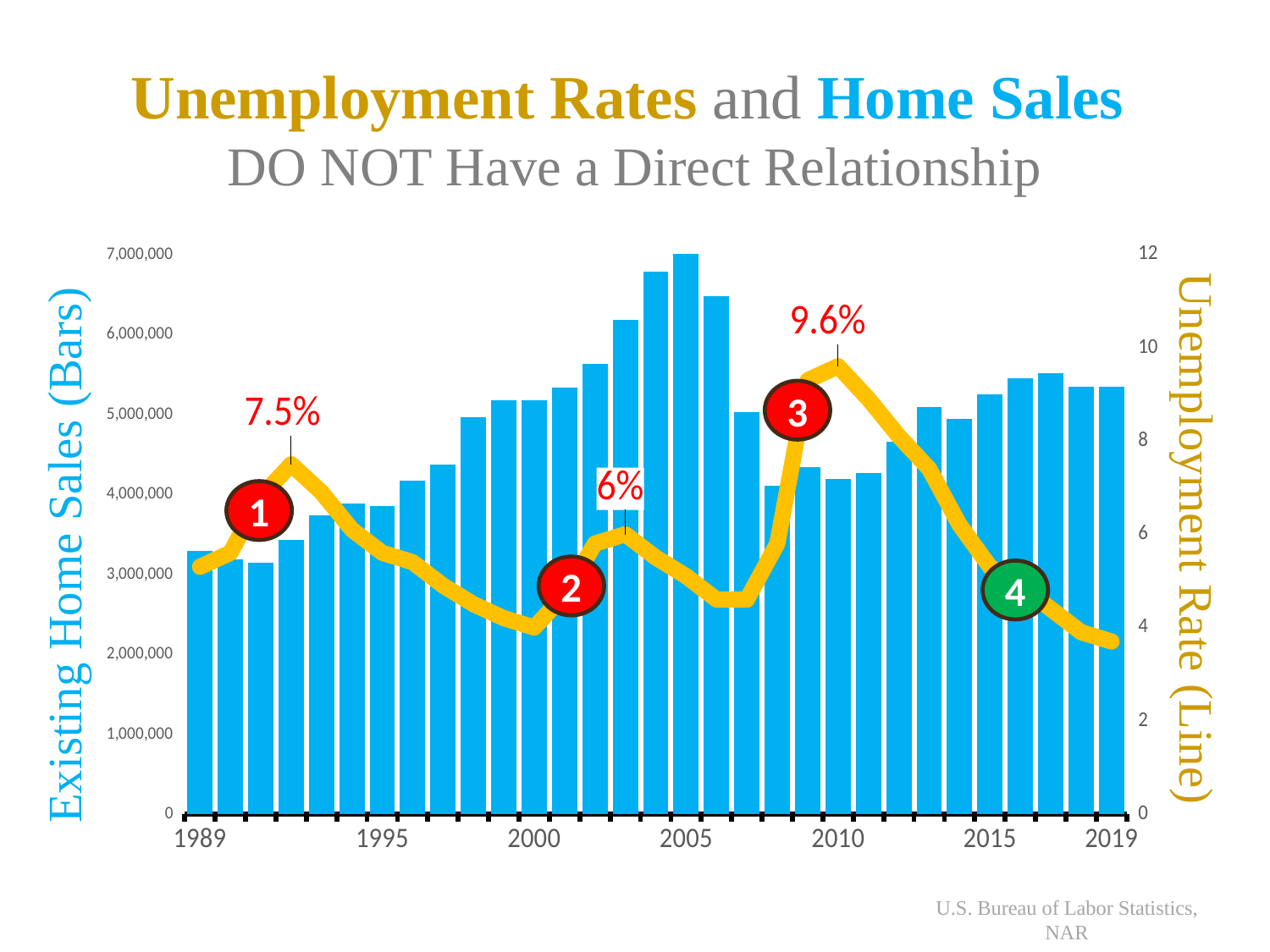
Is the existing home sales bar for 2010 greater or less than 5,000,000? less What is the title of the slide? Unemployment Rates and Home Sales DO NOT Have a Direct Relationship What unemployment rate is labeled on the line near 1992? 7.5% Which year has the tallest existing home sales bar? 2005 What unemployment rate is labeled on the line near 2003? 6% Which year has a larger existing home sales bar, 2005 or 2010? 2005 Does the unemployment rate line rise or fall from 2010 to 2019? It falls What is the difference between the 9.6% and 7.5% unemployment rate labels? 2.1 percentage points What is the highest unemployment rate value labeled on the line? 9.6% What is the label on the right-hand vertical axis? Unemployment Rate (Line) Is the existing home sales bar for 2005 greater or less than 6,000,000? greater What kind of chart is shown on the slide? A combination bar and line chart